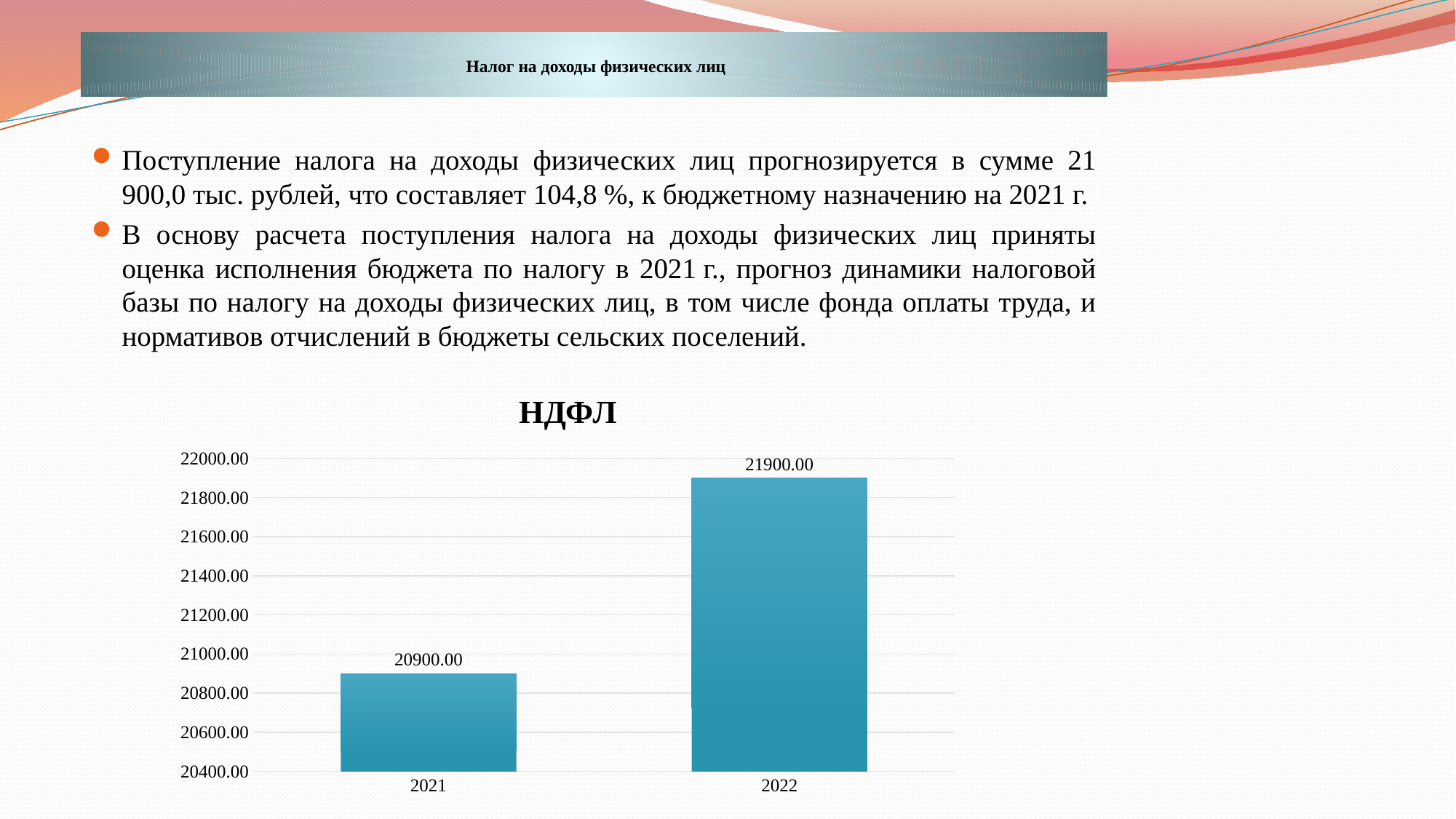
What is the title of the chart on the slide? НДФЛ Is the value for 2021 in the НДФЛ chart greater or less than 21000.00? less How many bars are shown in the НДФЛ chart? 2 Which year has the highest value in the НДФЛ chart? 2022 Do the values in the НДФЛ chart rise or fall from 2021 to 2022? rise What is the value for 2022 in the НДФЛ chart? 21900.00 What is the difference between the 2022 and 2021 values in the НДФЛ chart? 1000.00 Which year has the lowest value in the НДФЛ chart? 2021 What kind of chart is the НДФЛ chart? bar chart What is the value for 2021 in the НДФЛ chart? 20900.00 Is the value for 2022 in the НДФЛ chart greater or less than 21800.00? greater Which is larger in the НДФЛ chart, the value for 2021 or for 2022? 2022